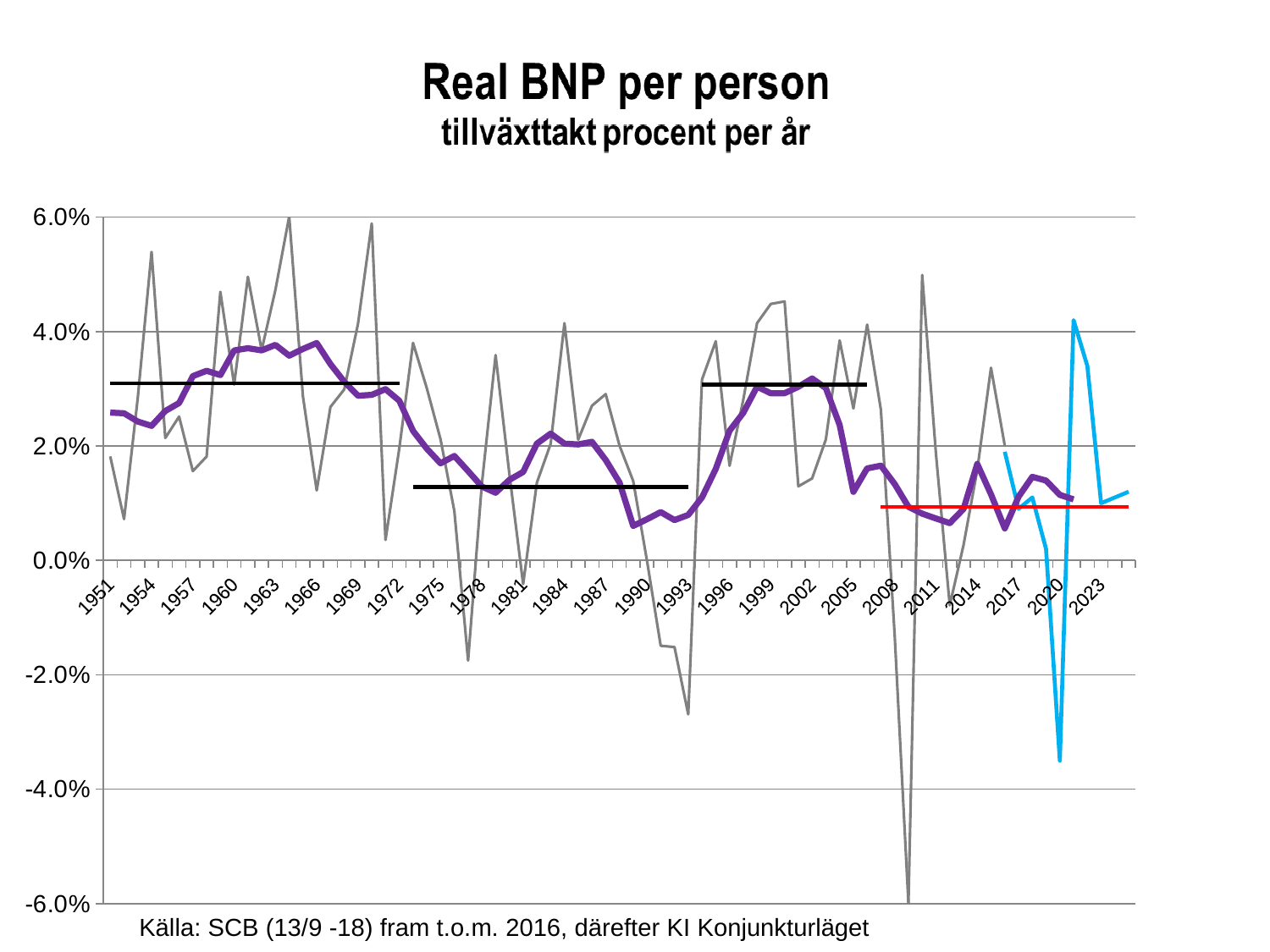
Does the purple line rise or fall between 1990 and 1999? rise Is the lowest value of the blue line, around 2020, greater or less than -2.0%? less Is the peak of the grey line around 1964 greater or less than 4.0%? greater What is the highest value shown on the y axis? 6.0% How many year labels are shown on the x axis? 25 Is the lowest value of the grey line, around 2009, greater or less than -4.0%? less What kind of chart is shown on the slide? line chart What is the title of the chart? Real BNP per person tillväxttakt procent per år Does the purple line rise or fall between 1963 and 1975? fall What is the lowest value shown on the y axis? -6.0% What colour is the line covering the forecast years after 2017? blue